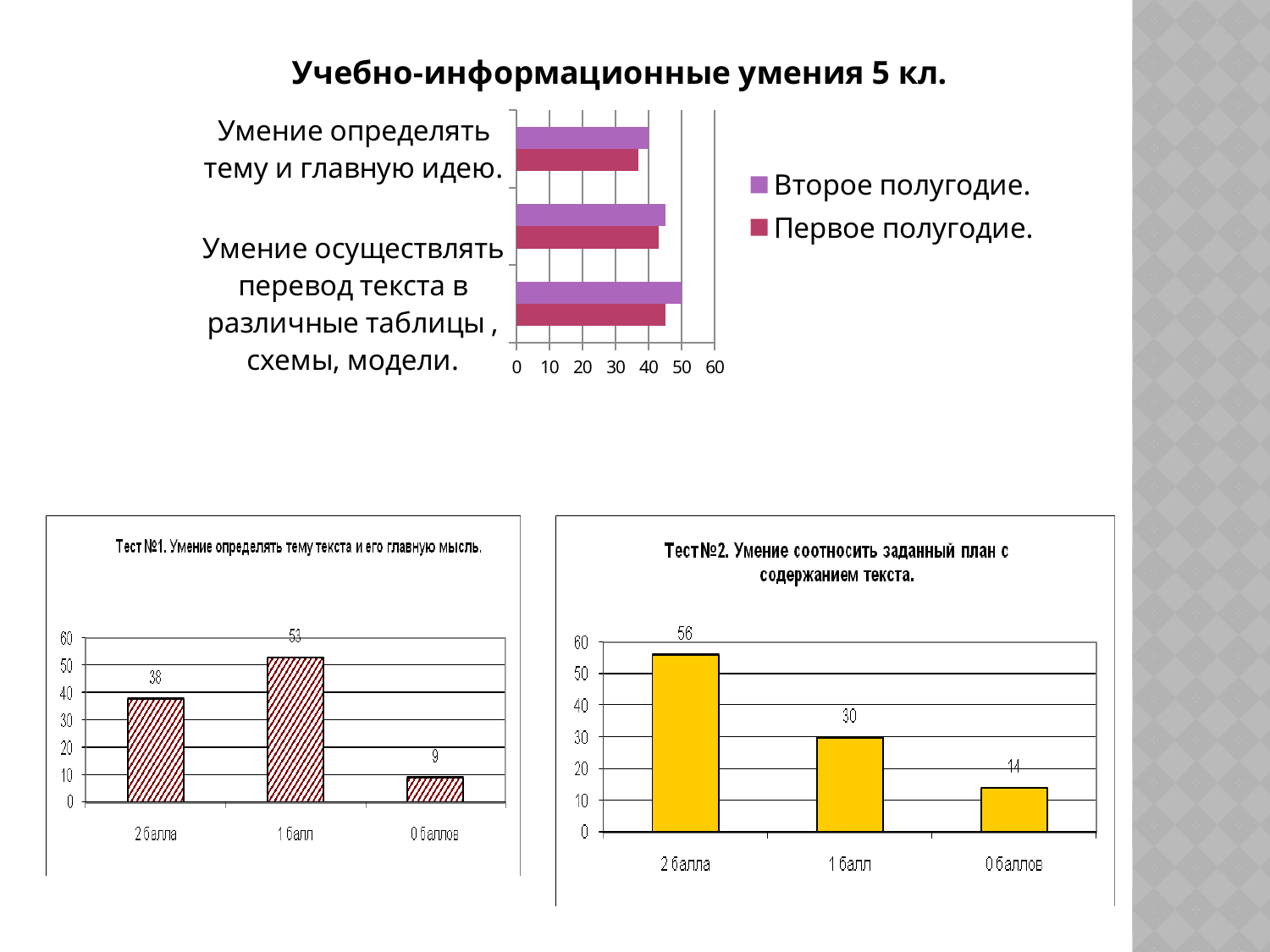
In the chart 'Тест №1. Умение определять тему текста и его главную мысль', what is the value for '1 балл'? 53 In the top chart 'Учебно-информационные умения 5 кл.', which series is shown in purple? Второе полугодие. In the chart 'Тест №2. Умение соотносить заданный план с содержанием текста', do the values rise or fall from left to right along the x axis? fall How many series does the legend list in the top chart 'Учебно-информационные умения 5 кл.'? 2 In the chart 'Тест №2. Умение соотносить заданный план с содержанием текста', which category has the highest value? 2 балла In the chart 'Тест №1. Умение определять тему текста и его главную мысль', which category has the lowest value? 0 баллов In the top chart 'Учебно-информационные умения 5 кл.', is the value of 'Второе полугодие.' for 'Умение осуществлять перевод текста в различные таблицы, схемы, модели.' greater or less than 40? greater What kind of chart is the top chart 'Учебно-информационные умения 5 кл.'? bar chart In the chart 'Тест №2. Умение соотносить заданный план с содержанием текста', what is the difference between the values for '1 балл' and '0 баллов'? 16 In the chart 'Тест №1. Умение определять тему текста и его главную мысль', what is the difference between the values for '1 балл' and '2 балла'? 15 In the chart 'Тест №2. Умение соотносить заданный план с содержанием текста', what is the value for '2 балла'? 56 How many categories are shown in the chart 'Тест №1. Умение определять тему текста и его главную мысль'? 3